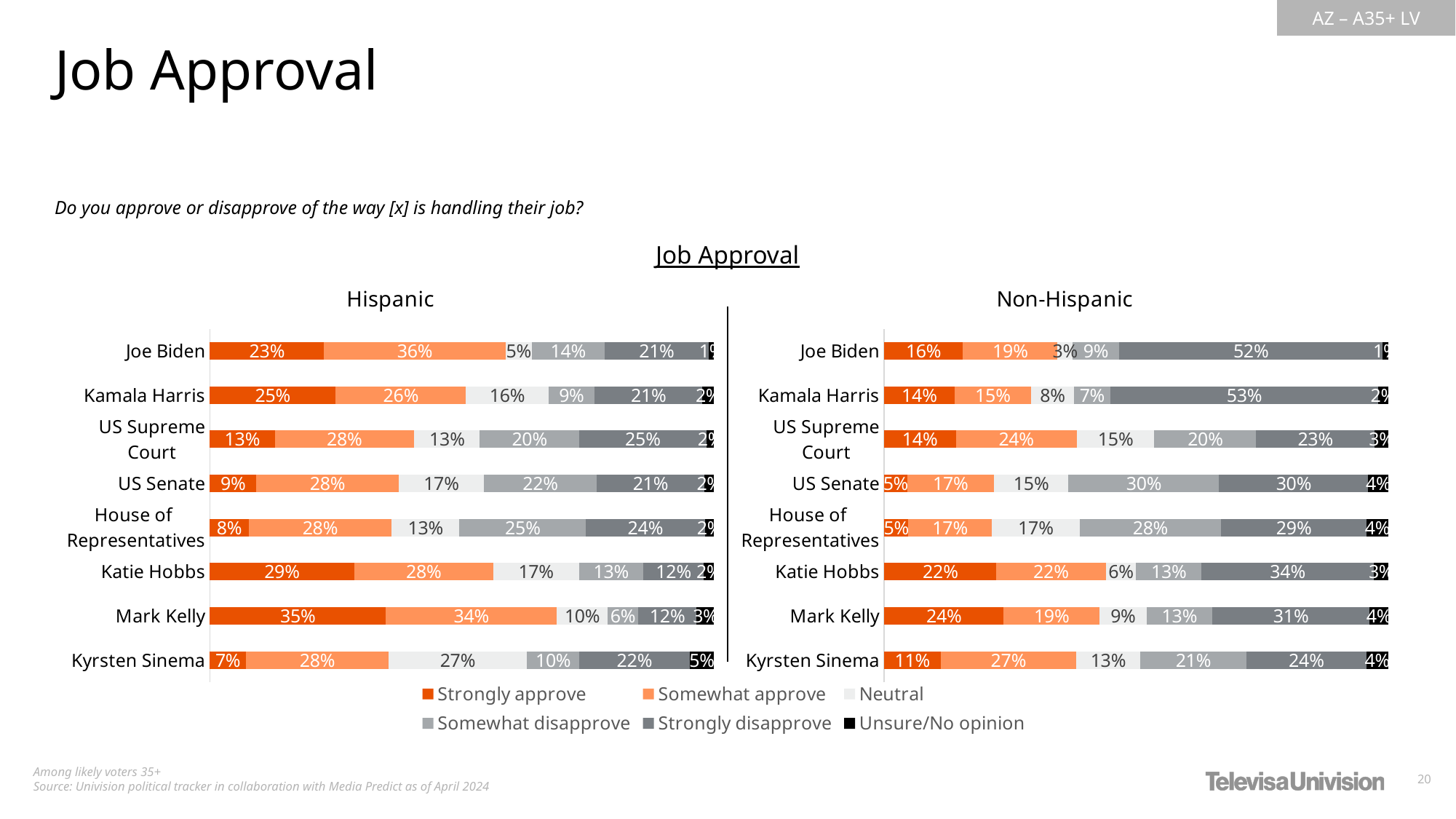
In the Hispanic chart, what percentage strongly approve of Mark Kelly? 35% What kind of chart is used for the Hispanic and Non-Hispanic panels? Stacked bar chart In the Hispanic chart, what is the combined Strongly approve and Somewhat approve value for Mark Kelly? 69% In the Hispanic chart, which person or institution has the highest Strongly approve value? Mark Kelly In the Non-Hispanic chart, what percentage somewhat approve of Kyrsten Sinema? 27% In the Hispanic chart, which person or institution has the highest Neutral value? Kyrsten Sinema What is the title shown above the two charts? Job Approval How many people or institutions are listed in the Hispanic chart? 8 In the Non-Hispanic chart, who has the larger Strongly approve value, Katie Hobbs or Mark Kelly? Mark Kelly In the Hispanic chart, what is the difference between the Strongly approve values for Mark Kelly and Kyrsten Sinema? 28 percentage points How many series does the legend list? 6 In the Non-Hispanic chart, what percentage strongly disapprove of Kamala Harris? 53%